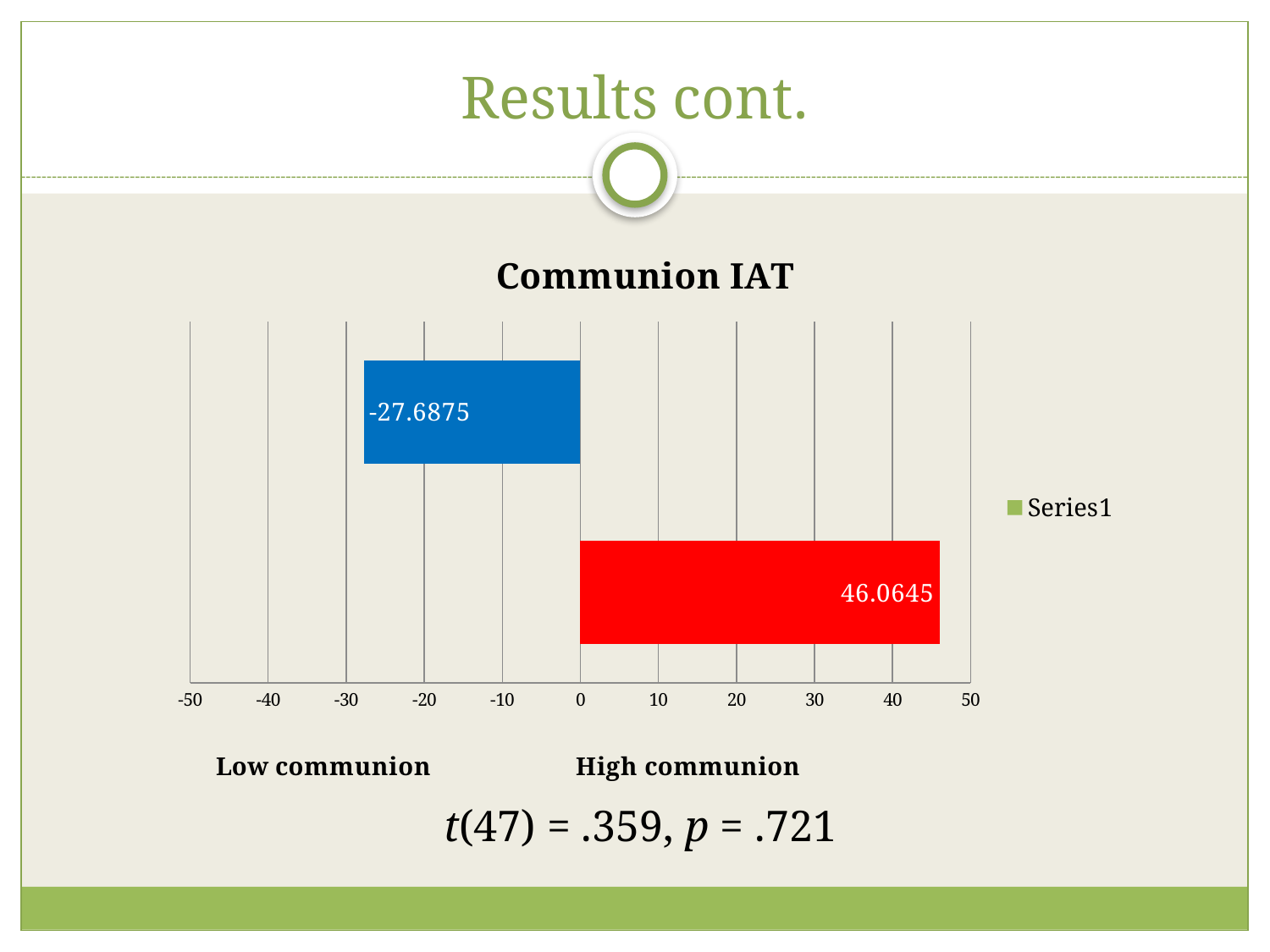
How many series does the legend list? 1 What is the name of the series shown in the legend? Series1 What is the title of the chart? Communion IAT How many bars are plotted in the chart? 2 What type of chart is shown on the slide? bar chart What is the value shown on the blue bar? -27.6875 What is the lowest value plotted in the chart? -27.6875 Is the value of the blue bar greater or less than -20? less Is the value of the red bar greater or less than 40? greater Which bar has the higher value, the blue bar or the red bar? red bar What is the difference between the red bar's value and the blue bar's value? 73.752 What is the value shown on the red bar? 46.0645